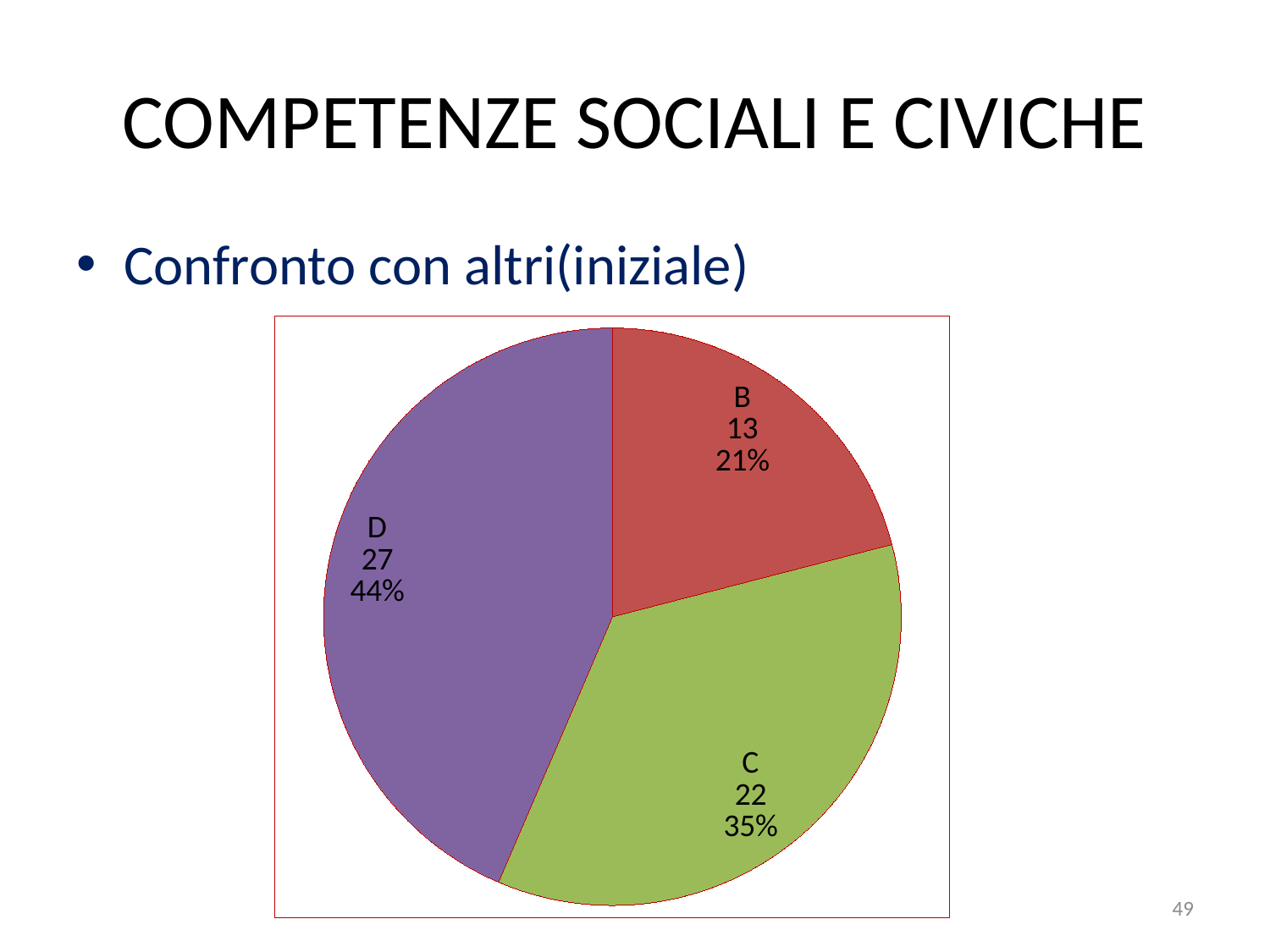
What percentage share does slice B have? 21% Which slice is the smallest? B How many slices does the pie chart have? 3 What is the value for slice D? 27 What colour is slice C? green What percentage share does slice D have? 44% What is the value for slice C? 22 What kind of chart is shown on the slide? pie chart Which is larger, the value for C or the value for B? C Which slice is the largest? D What is the difference between the values for D and B? 14 What is the value for slice B? 13